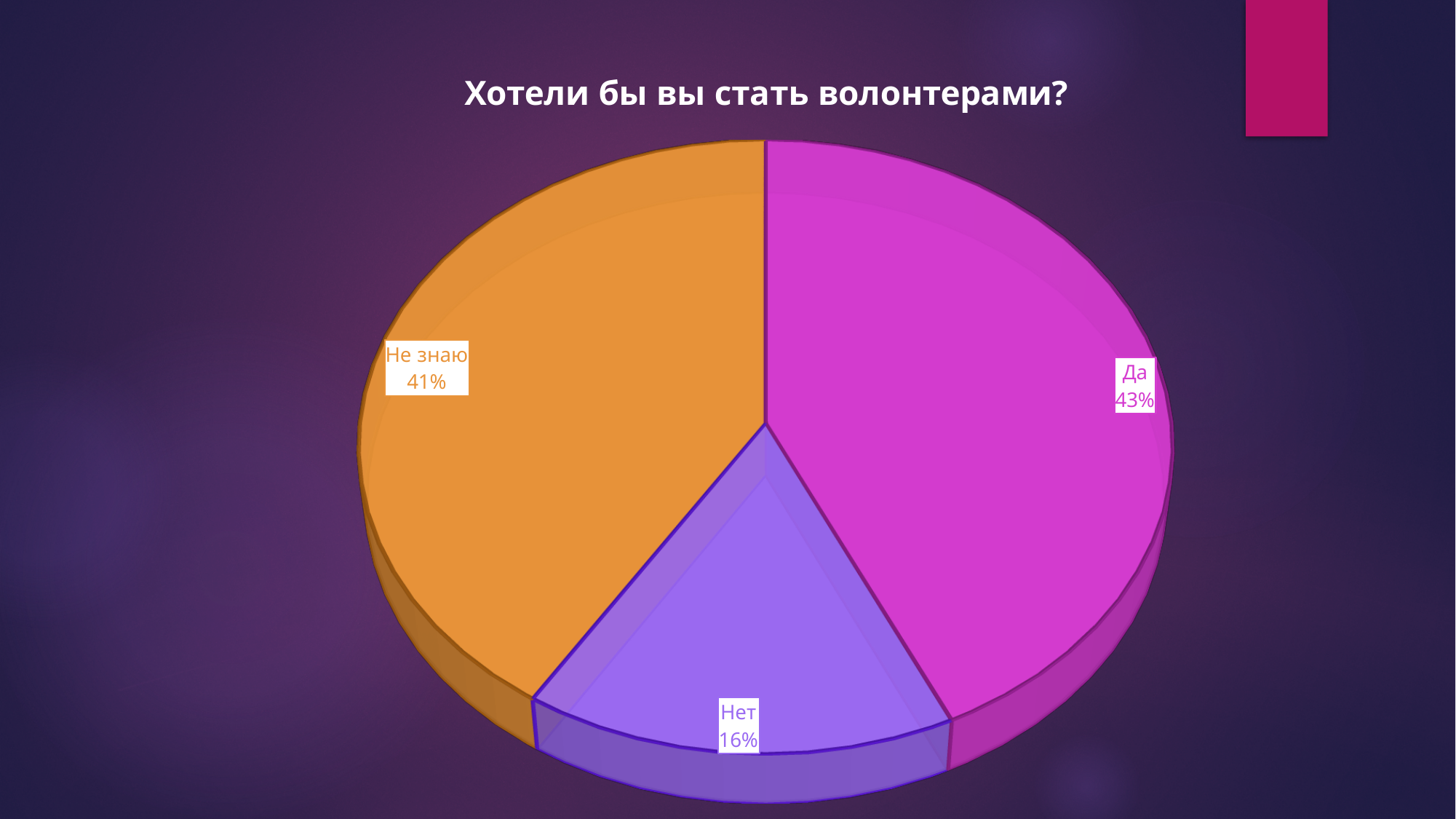
What colour is the "Нет" slice? purple What is the difference in percentage points between the "Да" and "Нет" slices? 27 How many slices does the pie chart have? 3 What is the difference in percentage points between the "Да" and "Не знаю" slices? 2 What share of the pie does the "Не знаю" slice represent? 41% Which slice of the pie is the smallest? Нет What share of the pie does the "Нет" slice represent? 16% What share of the pie does the "Да" slice represent? 43% Which is larger, the "Не знаю" slice or the "Нет" slice? Не знаю Is the share for "Нет" greater or less than 20%? less What is the title of the chart? Хотели бы вы стать волонтерами? What kind of chart is shown on the slide? pie chart